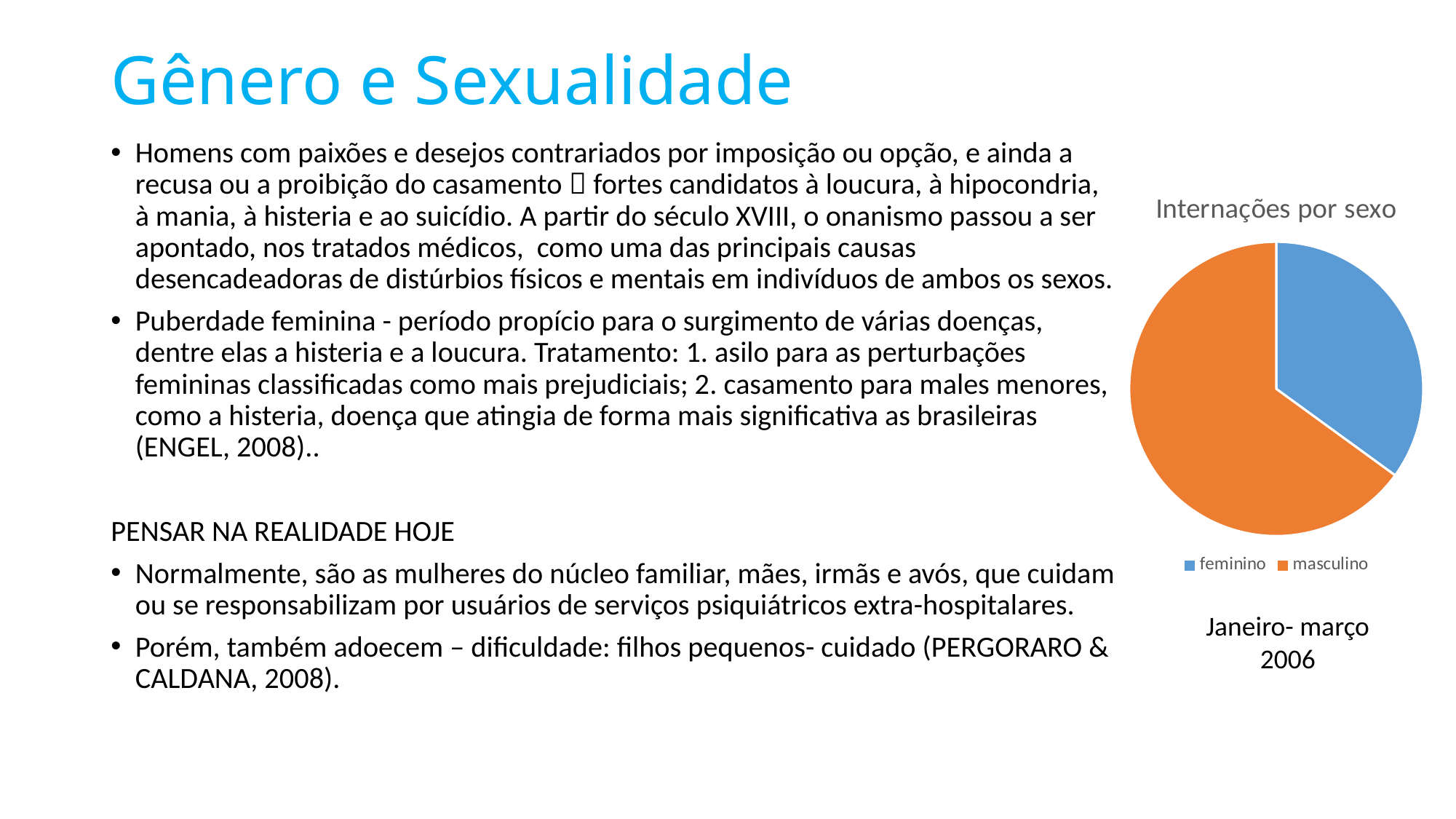
Which category has the smallest slice in the pie chart? feminino Which category has the largest slice in the pie chart? masculino How many entries does the chart's legend list? 2 Which slice is larger, feminino or masculino? masculino What is the title of the chart on the slide? Internações por sexo What colour represents masculino in the pie chart? orange What kind of chart is shown on the slide? pie chart How many slices does the pie chart have? 2 What period does the caption below the chart indicate the data covers? Janeiro- março 2006